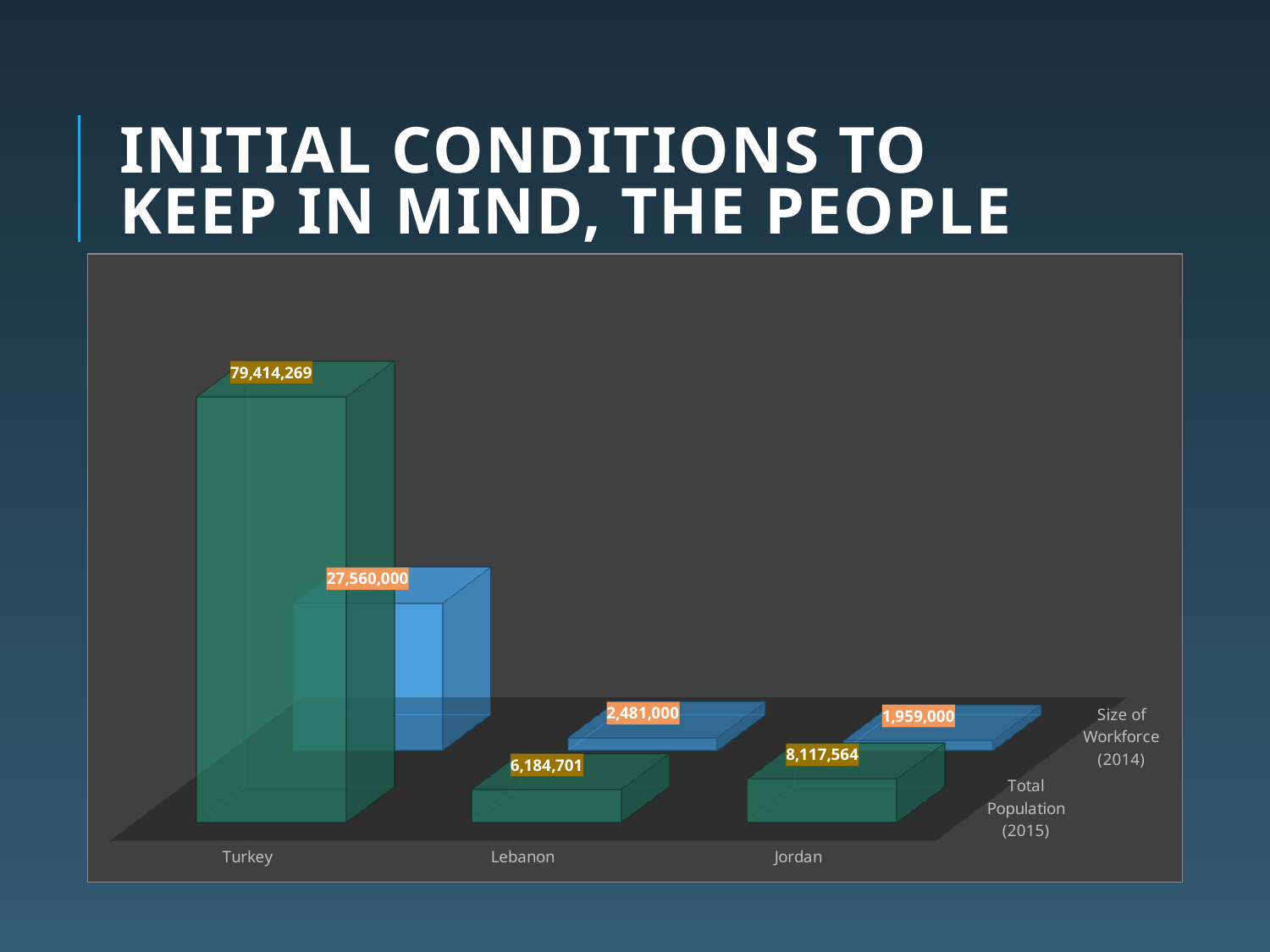
Which country has the lowest Total Population (2015)? Lebanon What is the Size of Workforce (2014) value for Turkey? 27,560,000 Which country has the highest Total Population (2015)? Turkey What is the Size of Workforce (2014) value for Lebanon? 2,481,000 Which country has the lowest Size of Workforce (2014)? Jordan What is the Total Population (2015) value for Turkey? 79,414,269 What is the difference between Jordan's and Lebanon's Total Population (2015)? 1,932,863 What is the Total Population (2015) value for Jordan? 8,117,564 What is the difference between Turkey's Total Population (2015) and its Size of Workforce (2014)? 51,854,269 How many countries are shown on the chart? 3 What kind of chart is shown on the slide? Bar chart Which is larger: Lebanon's Size of Workforce (2014) or Jordan's Size of Workforce (2014)? Lebanon's Size of Workforce (2014)